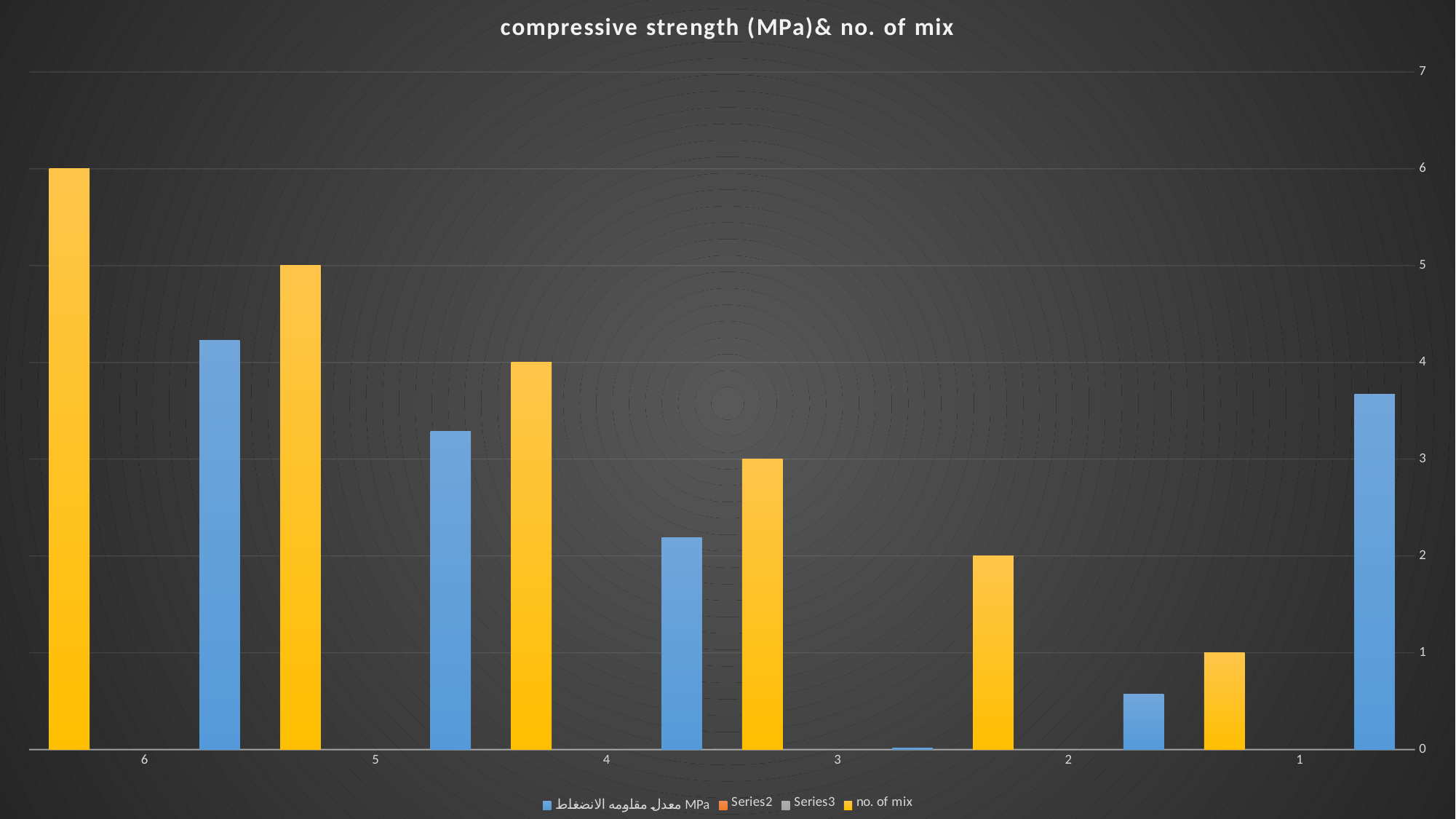
How many categories are shown on the x axis? 6 What is the value of the 'no. of mix' series for category 3? 3 How many series does the legend list? 4 Which category has the lowest 'no. of mix' value? 1 What is the difference between the 'no. of mix' values for category 6 and category 1? 5 What is the title of the chart? compressive strength (MPa)& no. of mix Which category has the highest 'no. of mix' value? 6 What is the value of the 'no. of mix' series for category 6? 6 Is the blue compressive strength value for category 2 greater or less than 1? less Do the 'no. of mix' values rise or fall from left to right along the x axis? fall Which is larger: the 'no. of mix' value for category 6 or for category 5? category 6 What kind of chart is shown on the slide? bar chart